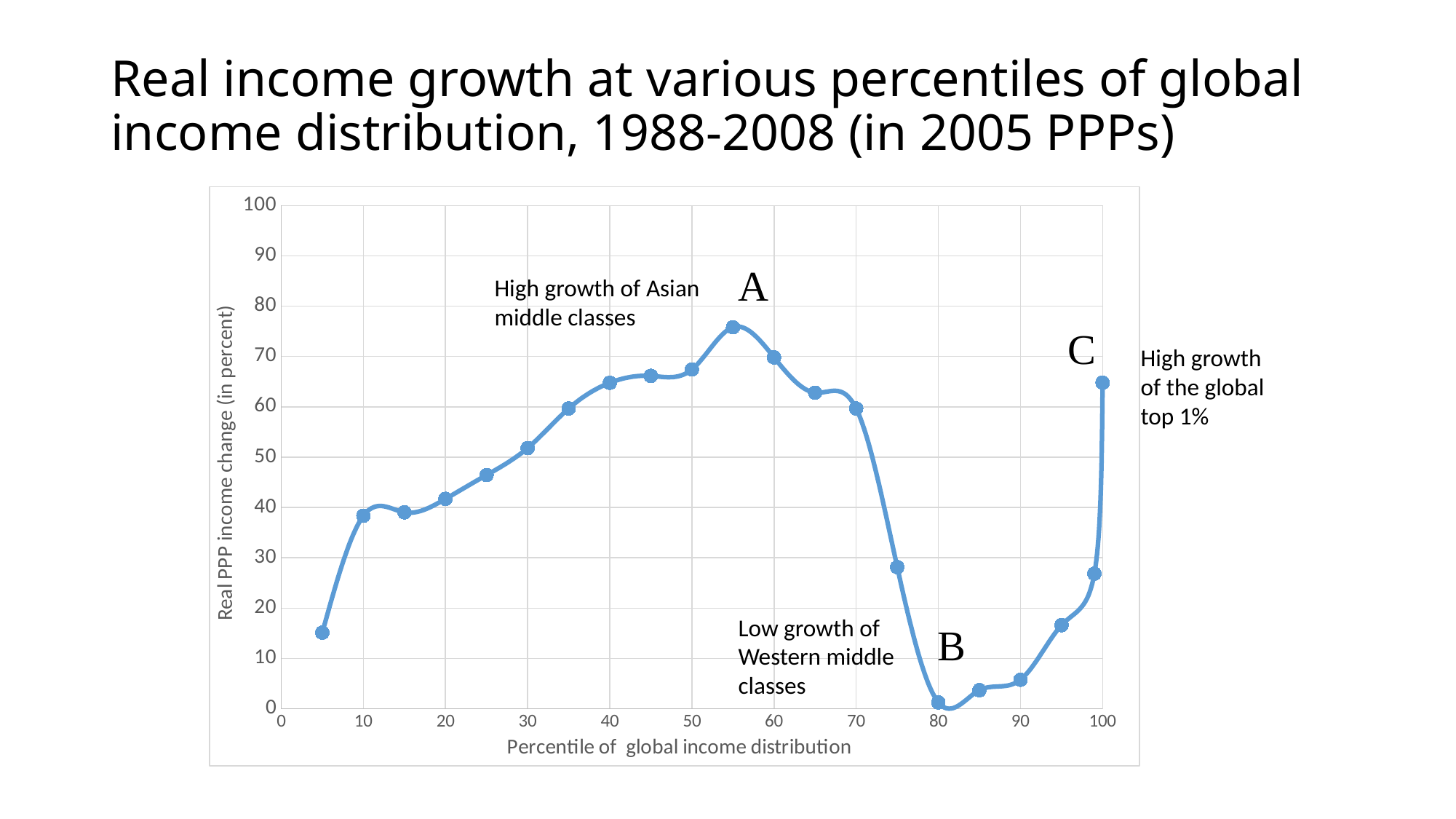
Is the real PPP income change at the 100th percentile greater or less than 60? greater At which percentile of the global income distribution does the real PPP income change reach its highest point? 55 Which has the larger real PPP income change: the 10th percentile or the 90th percentile? 10th percentile Is the real PPP income change at the 75th percentile greater or less than 40? less Is the real PPP income change at the 5th percentile greater or less than 20? less What is the label of the vertical axis? Real PPP income change (in percent) What kind of chart is shown on the slide? line chart Does the real PPP income change rise or fall as the percentile goes from 55 to 80? fall What annotation is written next to point B on the chart? Low growth of Western middle classes At which percentile of the global income distribution is the real PPP income change lowest? 80